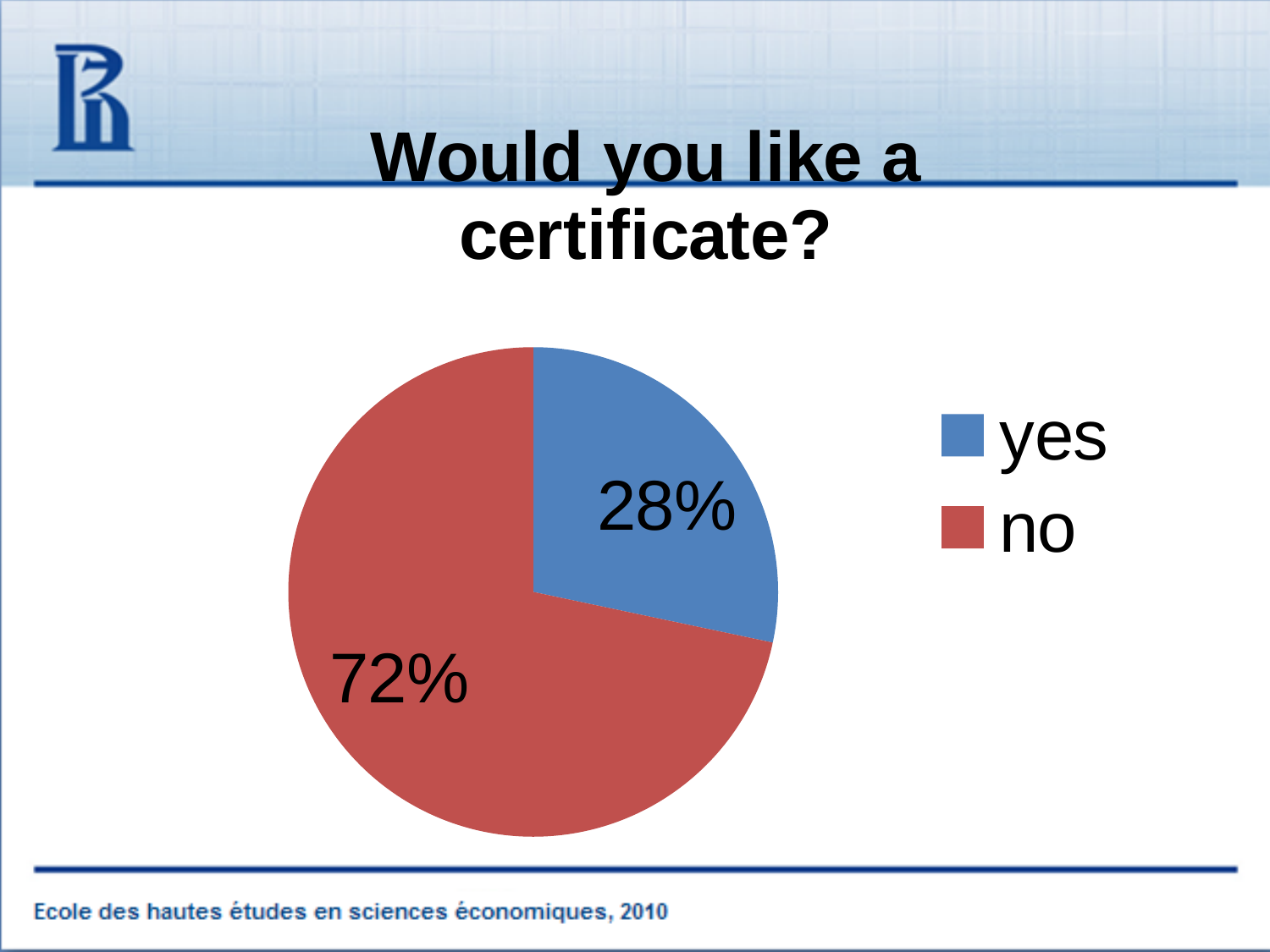
Which is larger, the share for "yes" or the share for "no"? no What is the title of the chart? Would you like a certificate? What kind of chart is shown on the slide? pie chart What percentage of respondents answered "no"? 72% Which response has the smallest share of the pie? yes How many entries does the legend list? 2 What share of the pie does the "yes" slice represent? 28% What colour is the "no" slice? red What percentage of respondents answered "yes"? 28% What is the difference in percentage points between the "no" and "yes" shares? 44 Which response has the largest share of the pie? no How many slices does the pie chart have? 2